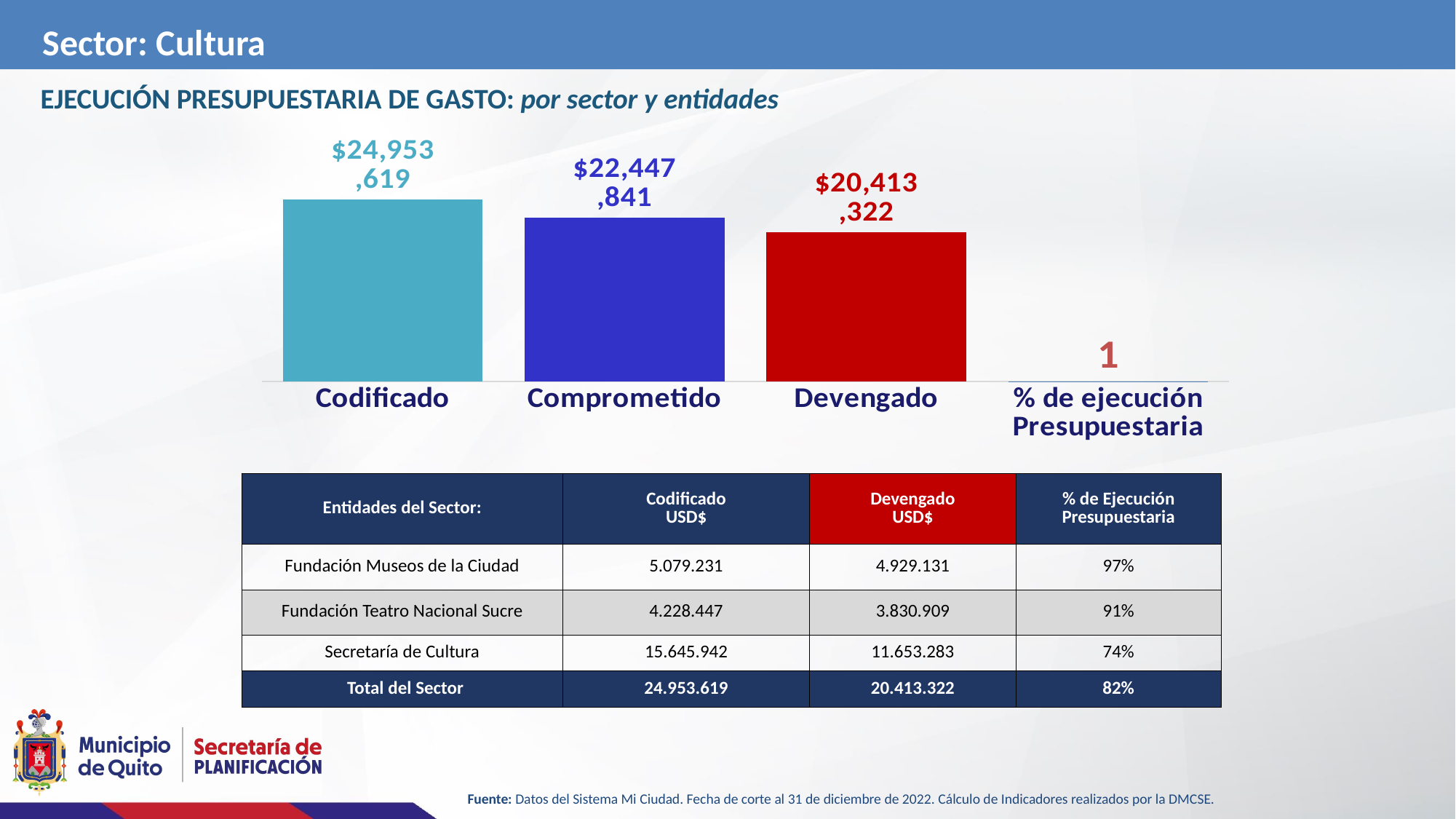
What is the difference between the Comprometido and Devengado values in the chart? $2,034,519 How many categories are shown on the x axis of the chart? 4 Which category has the highest value in the chart? Codificado Do the bar values rise or fall from Codificado to Devengado along the x axis? fall Which is larger in the chart, Codificado or Devengado? Codificado What is the value shown for Devengado in the chart? $20,413,322 What is the value shown for Comprometido in the chart? $22,447,841 What is the difference between the Codificado and Comprometido values in the chart? $2,505,778 What value is labelled for % de ejecución Presupuestaria in the chart? 1 What is the value shown for Codificado in the chart? $24,953,619 What kind of chart is shown on the slide? bar chart Which category has the lowest value in the chart? % de ejecución Presupuestaria